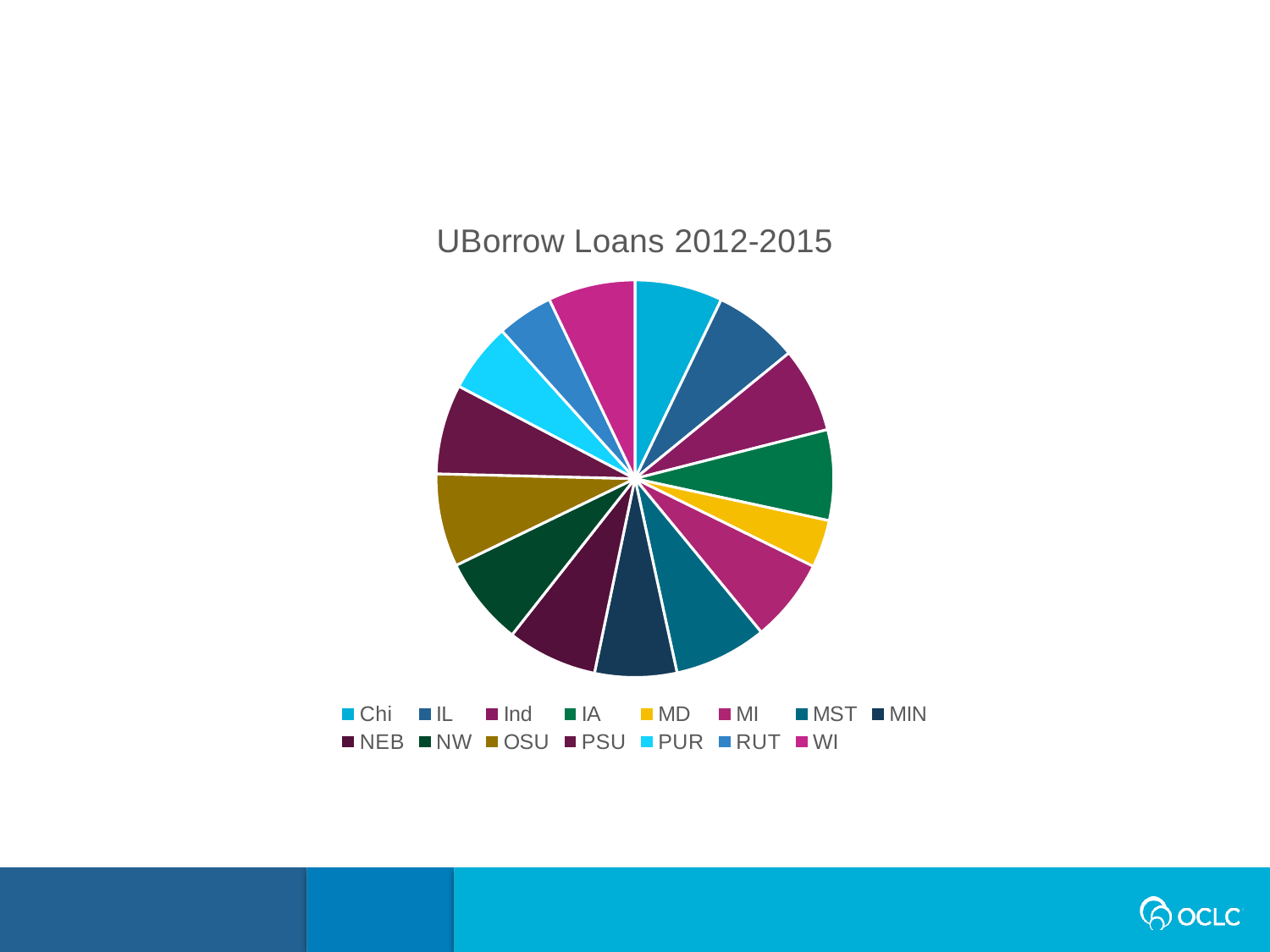
Which slice is larger, OSU or MD? OSU What colour is the MD slice in the pie chart? yellow What is the title of the chart? UBorrow Loans 2012-2015 How many categories (slices) does the pie chart have? 15 Which slice is larger, NW or MD? NW Which slice is larger, IA or MD? IA What kind of chart is shown on the slide? pie chart Which category has the smallest slice in the pie chart? MD How many entries does the legend list? 15